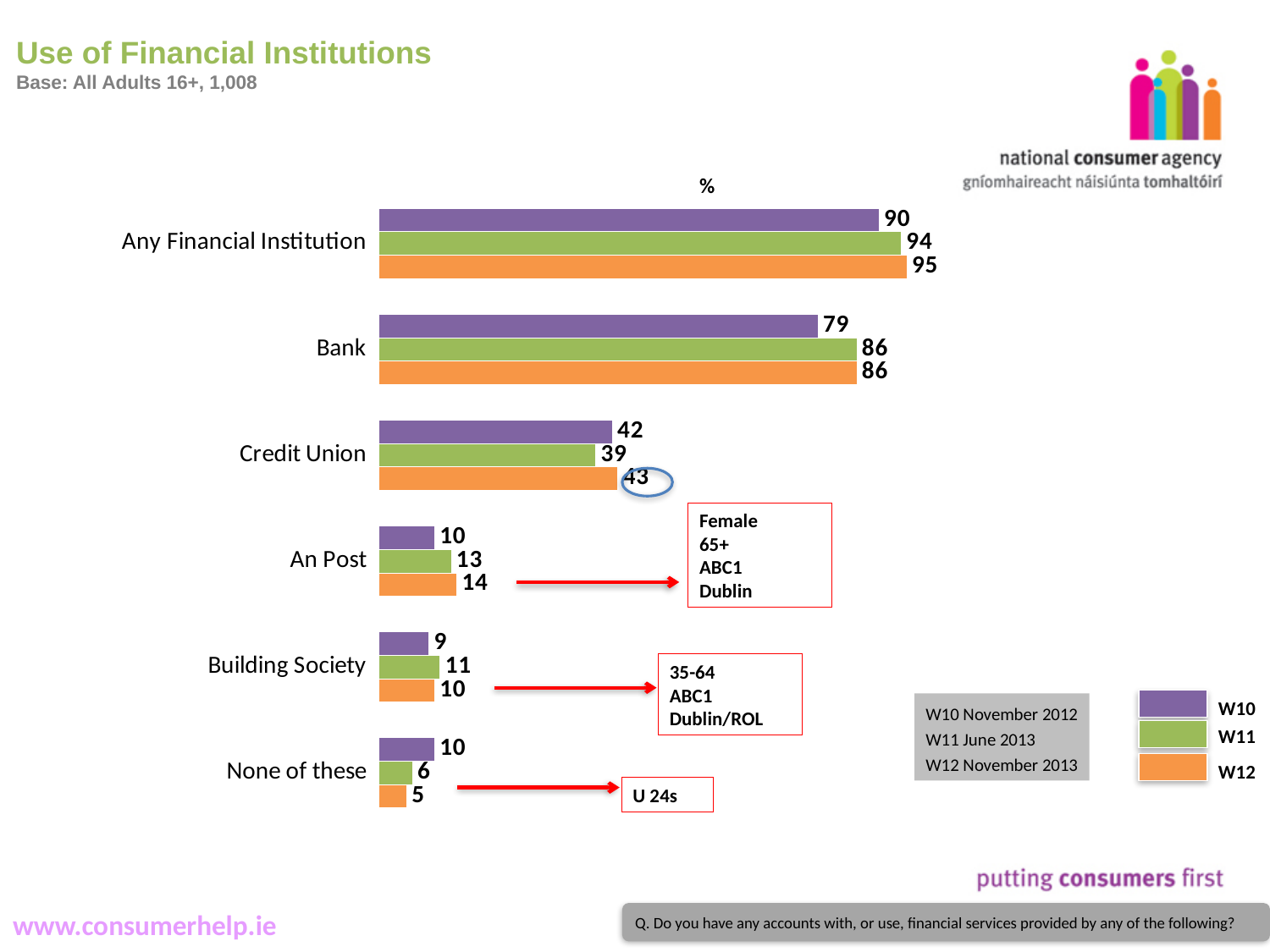
Which category has the highest W12 value? Any Financial Institution What is the W10 value for Bank? 79 Which category has the lowest W12 value? None of these What kind of chart is shown on the slide? bar chart How many categories are shown on the chart? 6 What is the W12 value for Credit Union? 43 What is the W11 value for An Post? 13 Which survey wave does the orange bar represent? W12 Do the values for None of these rise or fall from W10 to W12? fall How many series does the legend list? 3 Which is larger for Credit Union, the W10 value or the W11 value? W10 What is the difference between the W12 and W10 values for Bank? 7